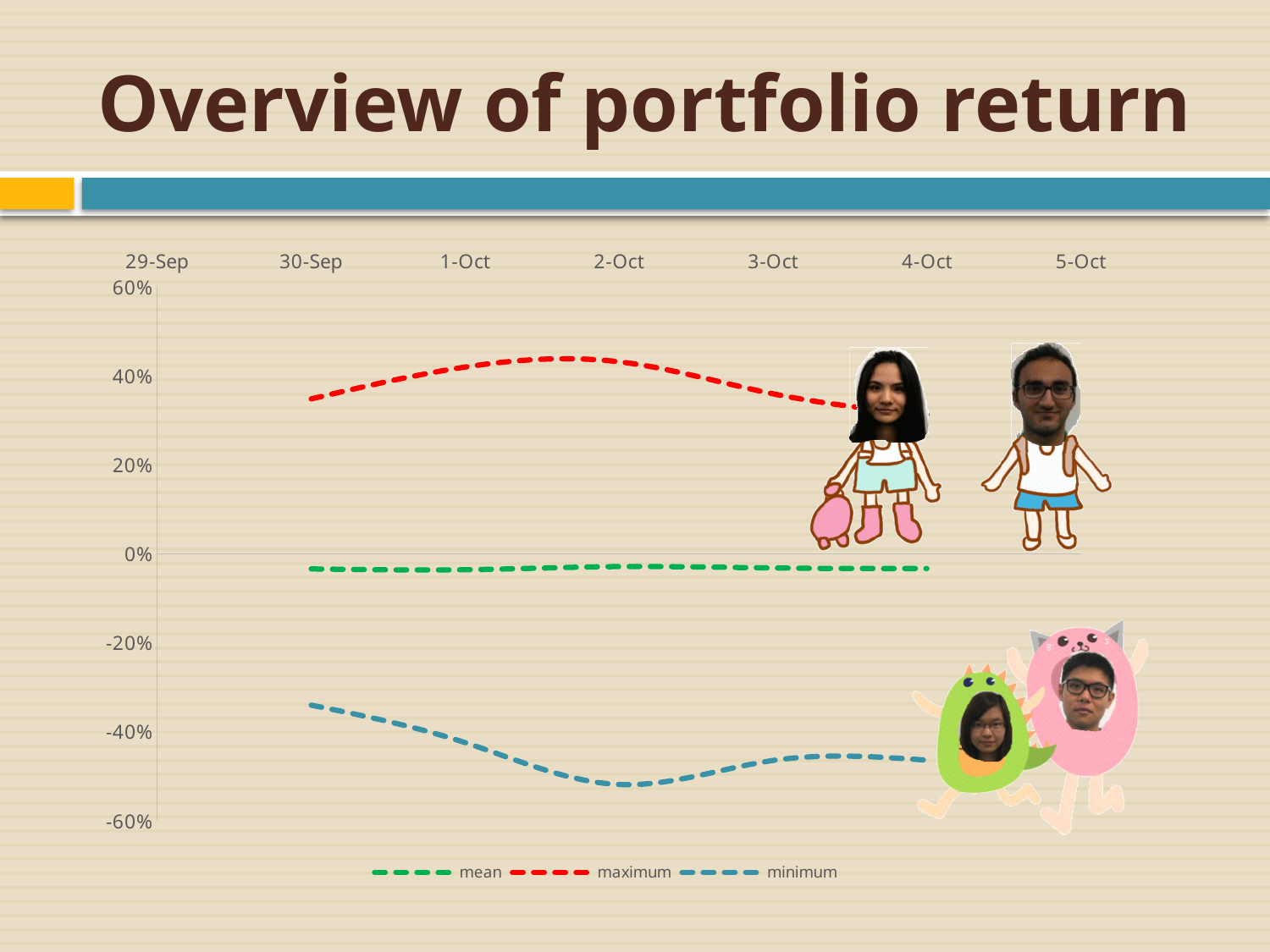
How many series does the legend list? 3 Which series is drawn with a red dashed line? maximum Is the value of the minimum series on 30-Sep greater or less than -40%? greater Is the value of the maximum series on 2-Oct greater or less than 40%? greater What are the three series named in the legend? mean, maximum, minimum On which date does the maximum series reach its highest point? 2-Oct Is the value of the minimum series on 2-Oct greater or less than -40%? less Which series has the highest values across the chart? maximum What kind of chart is shown on the slide? line chart How many dates are labelled on the x axis? 7 Does the minimum series rise or fall from 30-Sep to 2-Oct? fall